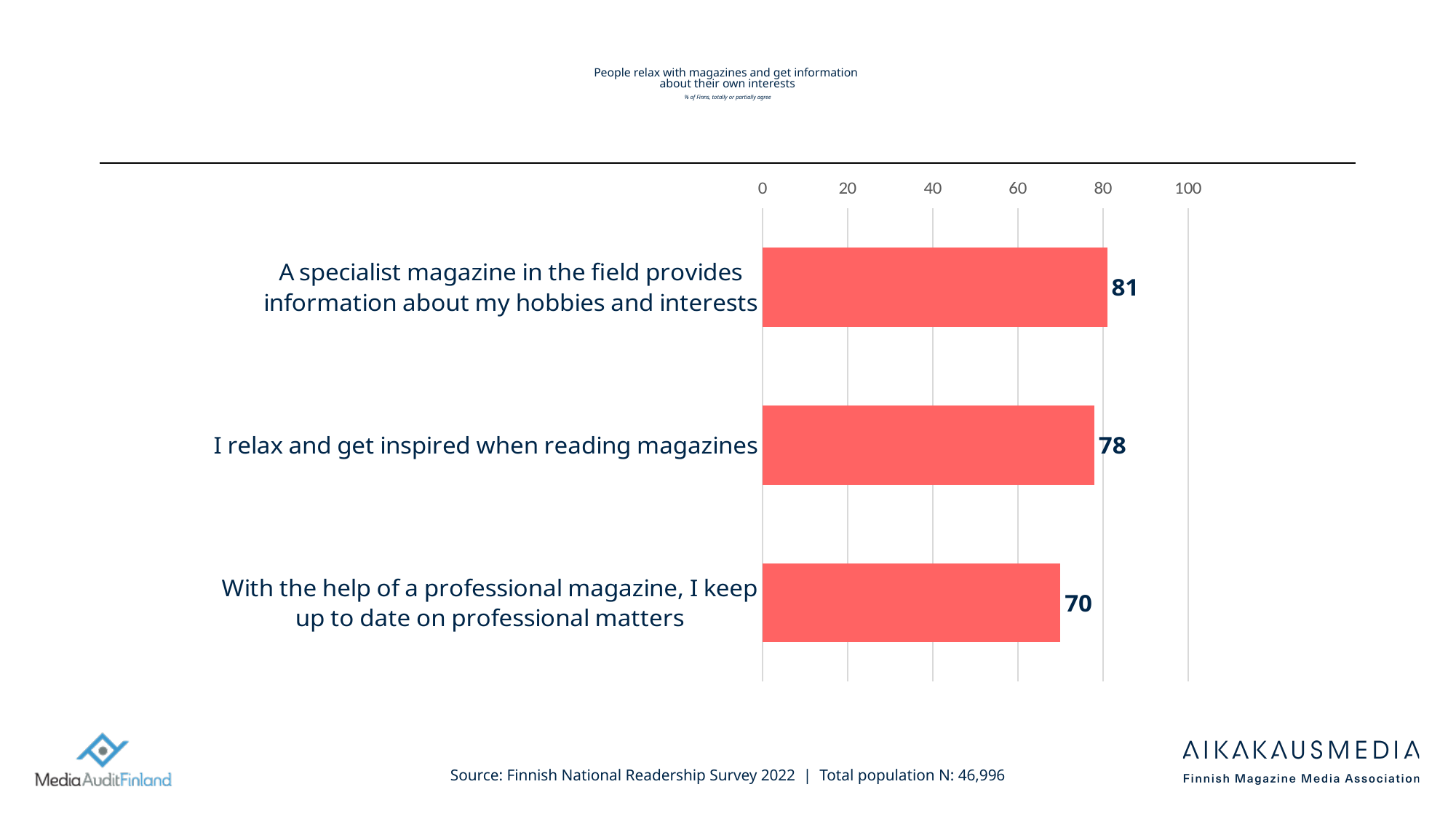
What is the difference between the values for "I relax and get inspired when reading magazines" and "With the help of a professional magazine, I keep up to date on professional matters"? 8 Which statement has the highest value? A specialist magazine in the field provides information about my hobbies and interests Which is larger: the value for "I relax and get inspired when reading magazines" or for "With the help of a professional magazine, I keep up to date on professional matters"? I relax and get inspired when reading magazines What is the value for "I relax and get inspired when reading magazines"? 78 What is the difference between the values for "A specialist magazine in the field provides information about my hobbies and interests" and "With the help of a professional magazine, I keep up to date on professional matters"? 11 Is the value for "I relax and get inspired when reading magazines" greater or less than 80? less How many statements are shown in the chart? 3 What is the title of the chart? People relax with magazines and get information about their own interests What is the value for "A specialist magazine in the field provides information about my hobbies and interests"? 81 What is the value for "With the help of a professional magazine, I keep up to date on professional matters"? 70 What kind of chart is shown on the slide? bar chart Which statement has the lowest value? With the help of a professional magazine, I keep up to date on professional matters